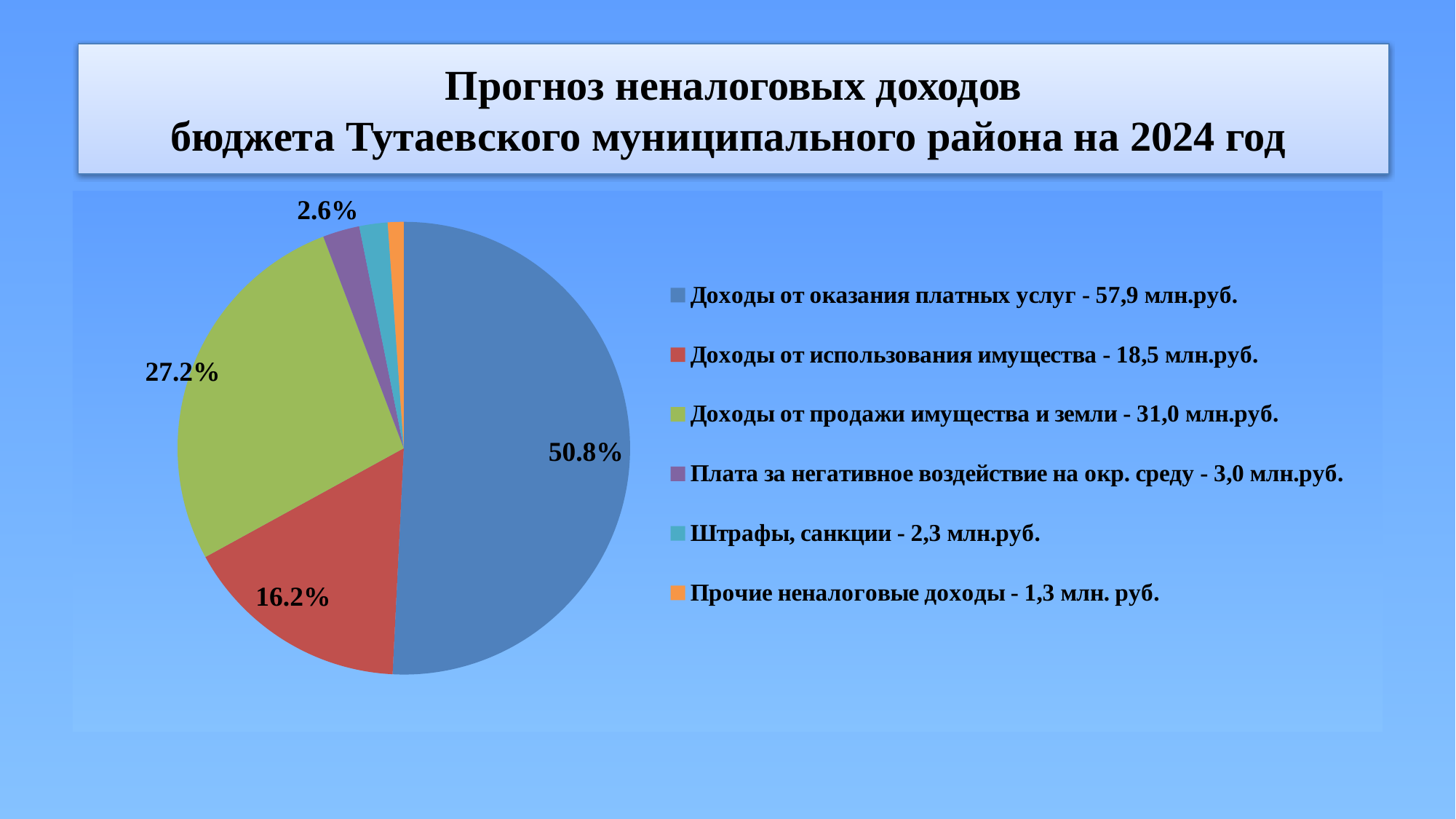
What is the difference in percentage points between the share for "Доходы от оказания платных услуг" and the share for "Доходы от продажи имущества и земли"? 23.6 What kind of chart is shown on the slide? pie chart What share of the pie does "Доходы от использования имущества" take? 16.2% Which slice is larger: "Доходы от продажи имущества и земли" or "Доходы от использования имущества"? Доходы от продажи имущества и земли What colour is the slice for "Доходы от продажи имущества и земли"? green What share of the pie does "Доходы от продажи имущества и земли" take? 27.2% What share of the pie does "Плата за негативное воздействие на окр. среду" take? 2.6% Which category has the largest slice of the pie? Доходы от оказания платных услуг According to the legend, what amount is given for "Штрафы, санкции"? 2,3 млн.руб. How many slices does the pie chart have? 6 Which category has the smallest slice of the pie? Прочие неналоговые доходы